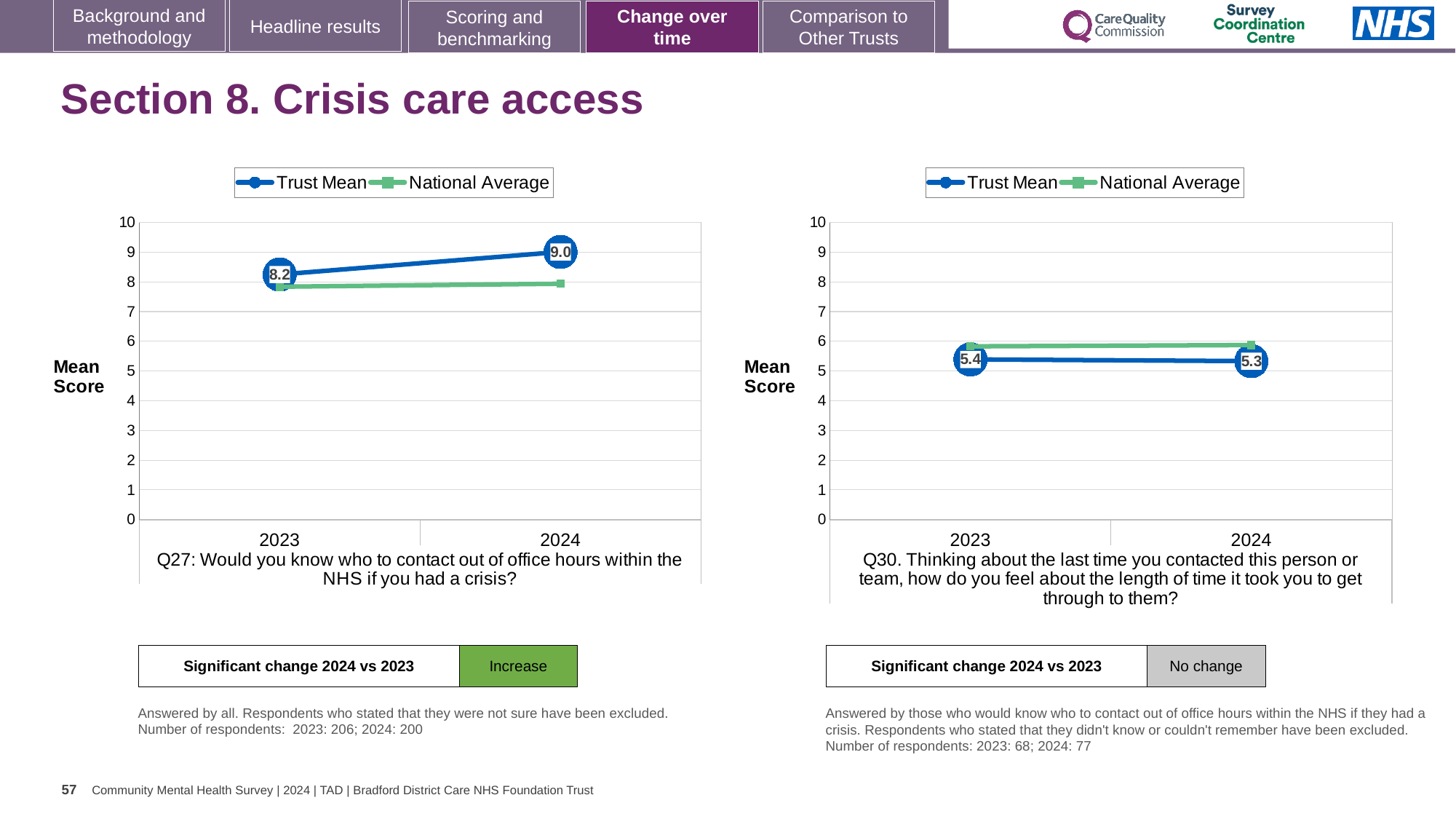
In the Q27 chart on the left, does the Trust Mean rise or fall from 2023 to 2024? rise In the Q27 chart on the left, what is the Trust Mean for 2023? 8.2 How many series does the legend of the Q30 chart on the right list? 2 In the Q30 chart on the right, which year has the higher Trust Mean, 2023 or 2024? 2023 How many years are shown on the x axis of the Q27 chart on the left? 2 In the Q27 chart on the left, what is the Trust Mean for 2024? 9.0 In the Q27 chart on the left, is the National Average for 2023 greater or less than 7? greater In the Q27 chart on the left, by how much did the Trust Mean change from 2023 to 2024? 0.8 In the Q30 chart on the right, is the National Average for 2024 greater or less than 5? greater What kind of chart is the Q27 chart on the left? line chart In the Q30 chart on the right, what is the Trust Mean for 2024? 5.3 In the Q30 chart on the right, what is the Trust Mean for 2023? 5.4